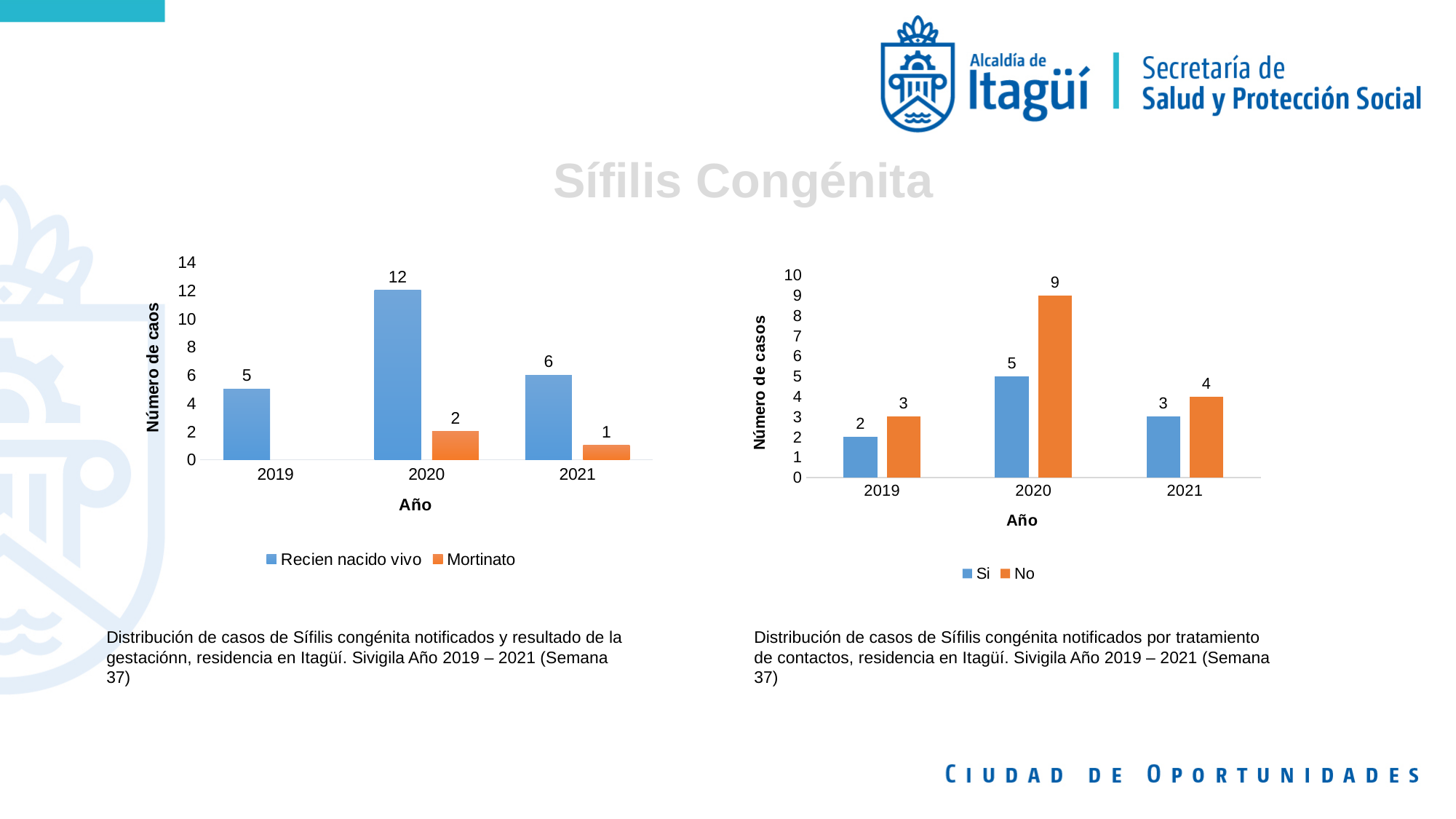
In the right chart (tratamiento de contactos), what is the label of the y axis? Número de casos In the left chart (resultado de la gestación), what is the value for Mortinato in 2021? 1 In the right chart (tratamiento de contactos), what is the value for Si in 2019? 2 In the right chart (tratamiento de contactos), which is larger in 2021, Si or No? No In the right chart (tratamiento de contactos), which year has the lowest value for Si? 2019 In the left chart (resultado de la gestación), what is the difference between Recien nacido vivo and Mortinato in 2020? 10 In the right chart (tratamiento de contactos), how many years are shown on the x axis? 3 In the left chart (resultado de la gestación), what is the value for Recien nacido vivo in 2020? 12 In the left chart (resultado de la gestación), what kind of chart is shown? Bar chart In the left chart (resultado de la gestación), which year has the highest value for Recien nacido vivo? 2020 In the left chart (resultado de la gestación), how many series does the legend list? 2 In the right chart (tratamiento de contactos), what is the value for No in 2020? 9